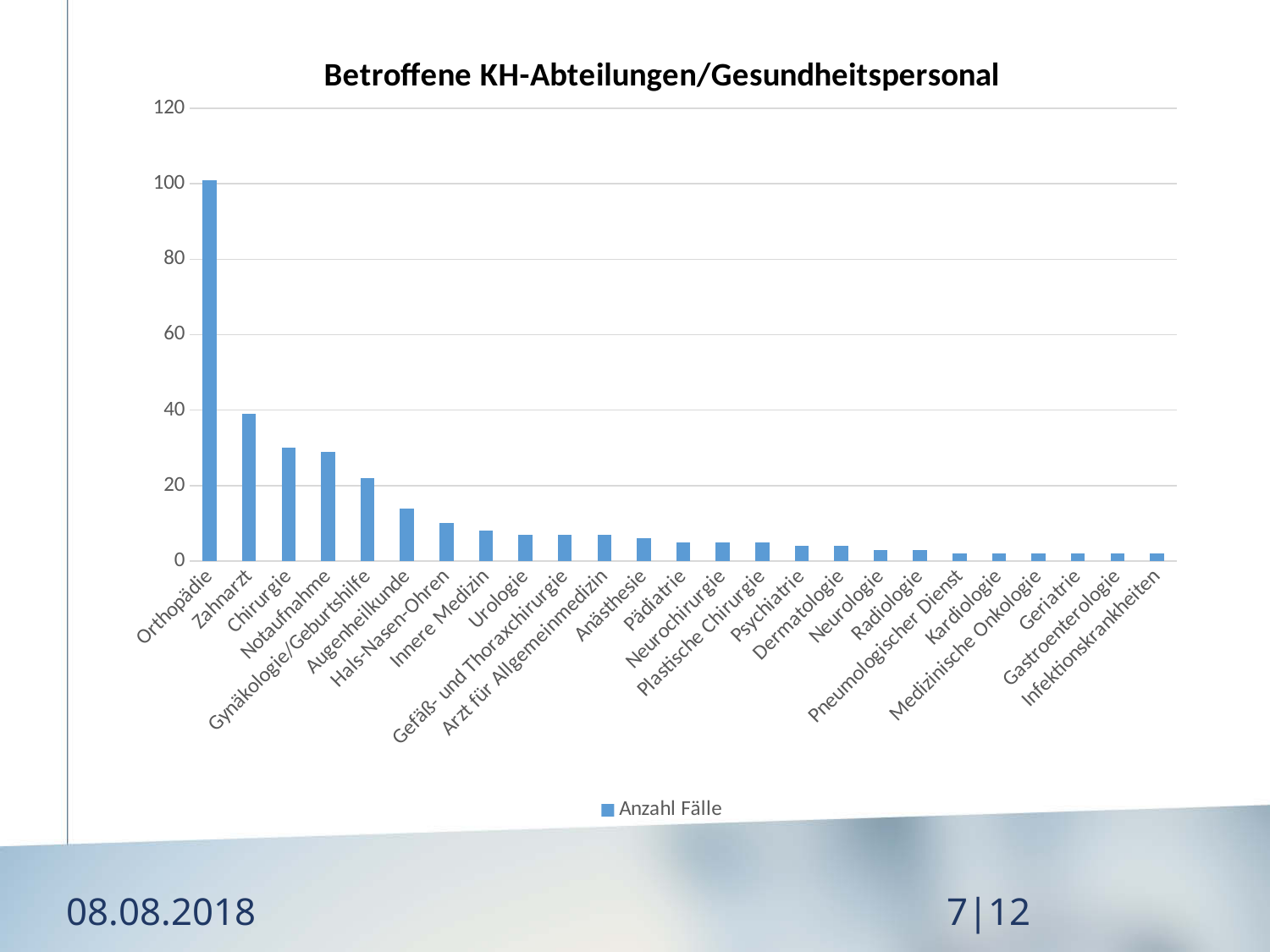
How many series does the legend list? 1 How many categories are shown on the x axis? 25 Which category has the highest value? Orthopädie What is the name of the series shown in the legend? Anzahl Fälle Which is larger, the value for Zahnarzt or the value for Chirurgie? Zahnarzt What kind of chart is shown on the slide? bar chart Do the values rise or fall from left to right along the x axis? fall What is the title of the chart? Betroffene KH-Abteilungen/Gesundheitspersonal Is the value for Gynäkologie/Geburtshilfe greater or less than 40? less Is the value for Orthopädie greater or less than 80? greater Is the value for Zahnarzt greater or less than 20? greater